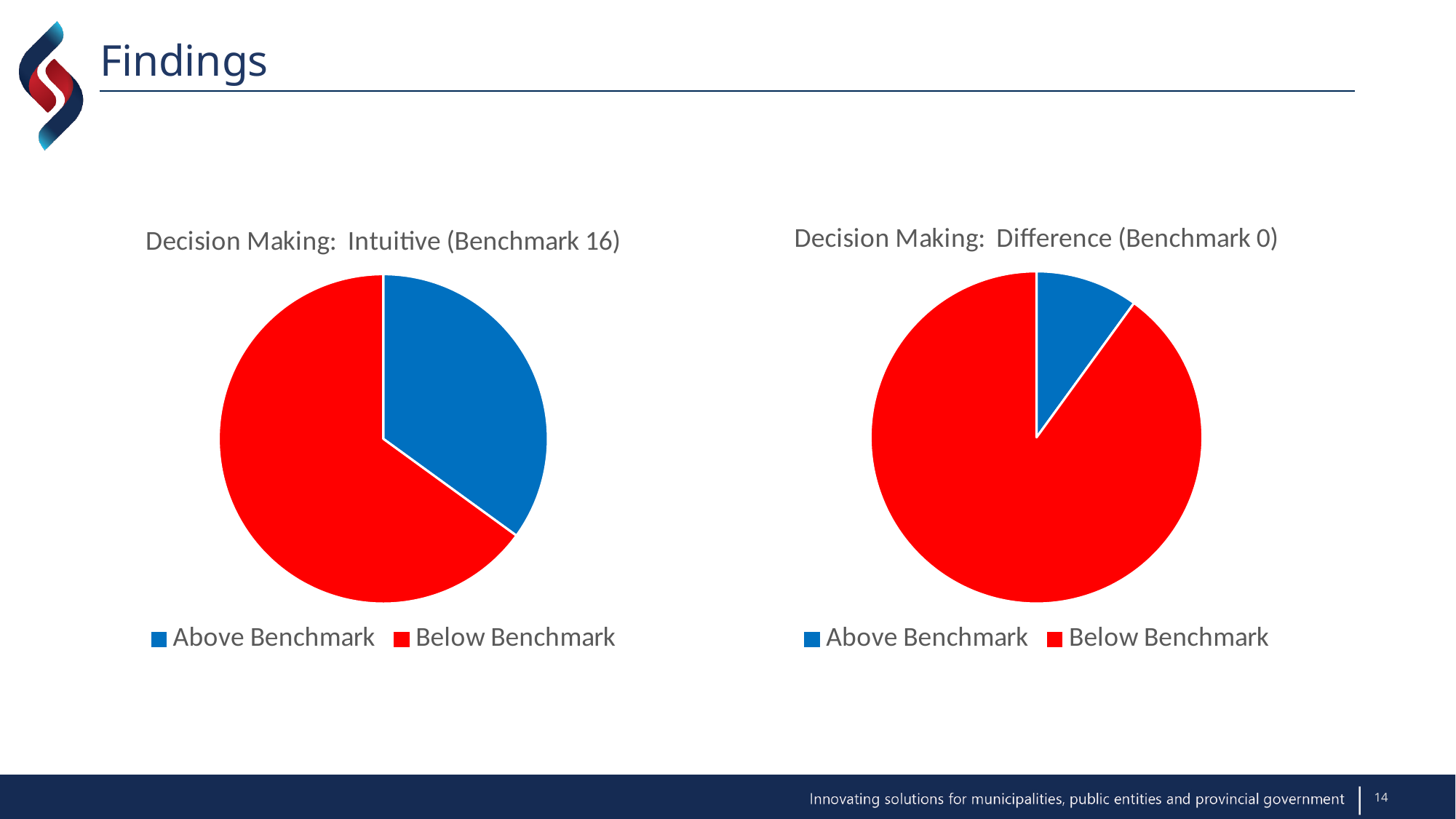
How many entries does the legend of the "Decision Making: Intuitive (Benchmark 16)" chart list? 2 What kind of chart is the "Decision Making: Difference (Benchmark 0)" chart? Pie chart What is the title of the chart on the left of the slide? Decision Making: Intuitive (Benchmark 16) In the "Decision Making: Intuitive (Benchmark 16)" chart, which category has the smallest slice? Above Benchmark In the "Decision Making: Difference (Benchmark 0)" chart, which category has the smallest slice? Above Benchmark In the "Decision Making: Intuitive (Benchmark 16)" chart, is the Above Benchmark slice larger or smaller than the Below Benchmark slice? Smaller In the "Decision Making: Difference (Benchmark 0)" chart, what colour represents Below Benchmark? Red Which chart has the larger Above Benchmark slice, "Decision Making: Intuitive (Benchmark 16)" or "Decision Making: Difference (Benchmark 0)"? Decision Making: Intuitive (Benchmark 16) In the "Decision Making: Intuitive (Benchmark 16)" chart, which category has the largest slice? Below Benchmark What kind of chart is the "Decision Making: Intuitive (Benchmark 16)" chart? Pie chart In the "Decision Making: Difference (Benchmark 0)" chart, which category has the largest slice? Below Benchmark How many categories does the "Decision Making: Difference (Benchmark 0)" pie chart show? 2